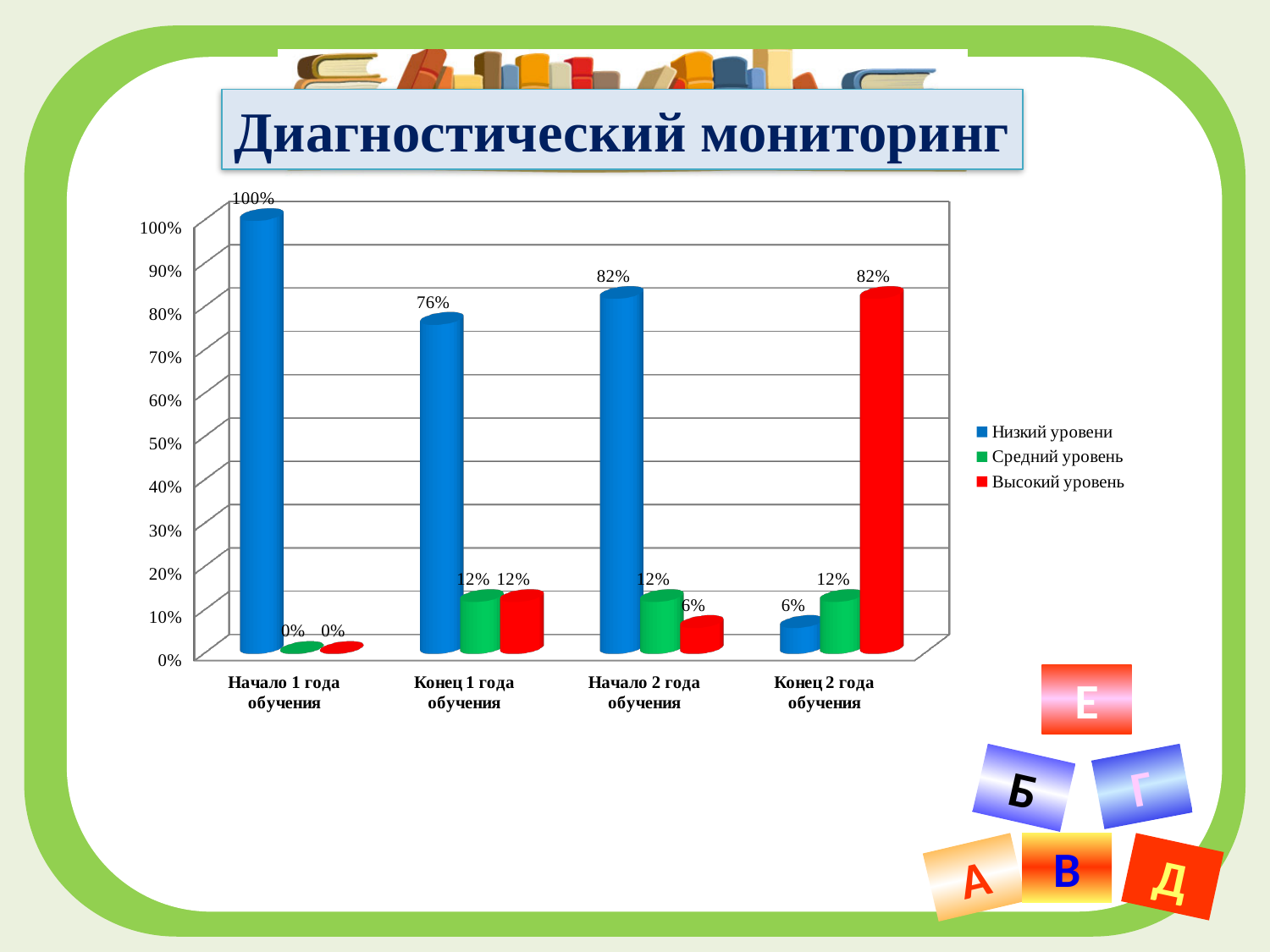
What kind of chart is shown on the slide? Bar chart How many categories are shown on the x axis? 4 In which category is the value for Низкий уровени lowest? Конец 2 года обучения What is the value for Средний уровень at Конец 1 года обучения? 12% How many series does the legend list? 3 What is the value for Высокий уровень at Начало 2 года обучения? 6% What colour represents Высокий уровень in the chart? Red What is the value for Высокий уровень at Конец 2 года обучения? 82% What is the value for Низкий уровени at Начало 1 года обучения? 100% In which category is the value for Высокий уровень highest? Конец 2 года обучения Which is larger at Начало 2 года обучения: Средний уровень or Высокий уровень? Средний уровень What is the difference between the Низкий уровени values at Начало 1 года обучения and Конец 1 года обучения? 24%